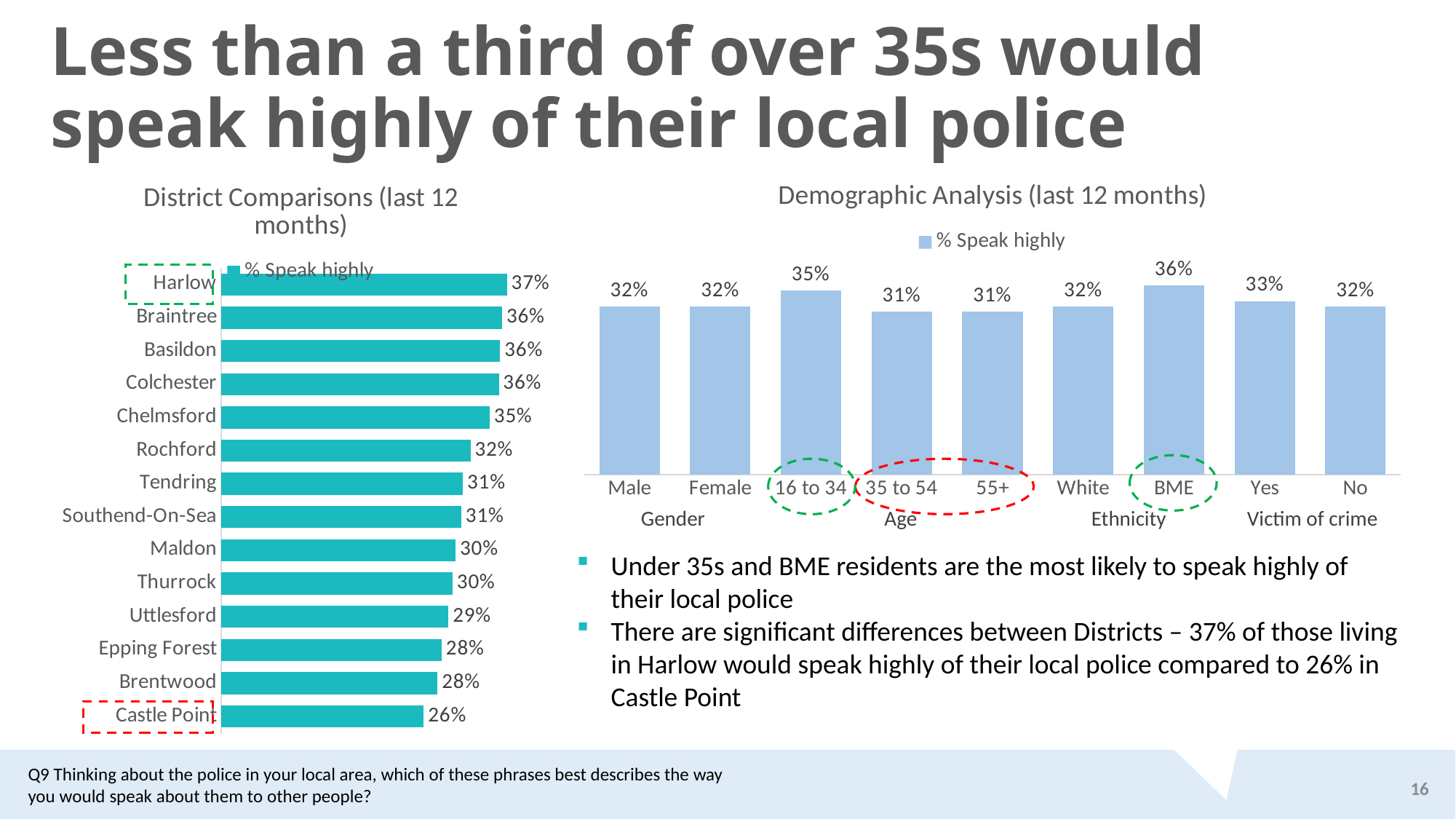
In the District Comparisons chart, how many districts are shown? 14 In the Demographic Analysis chart, which category has the highest value? BME In the District Comparisons chart, which district has the lowest value? Castle Point In the District Comparisons chart, what is the value for Harlow? 37% In the District Comparisons chart, what is the value for Chelmsford? 35% What type of chart is the Demographic Analysis chart? Bar chart In the Demographic Analysis chart, what series does the legend list? % Speak highly In the Demographic Analysis chart, how many categories are plotted? 9 In the District Comparisons chart, which is larger, the value for Rochford or the value for Maldon? Rochford In the District Comparisons chart, what is the difference between Harlow and Castle Point? 11 percentage points In the Demographic Analysis chart, what is the difference between the 16 to 34 and 55+ values? 4 percentage points In the Demographic Analysis chart, what is the value for BME? 36%